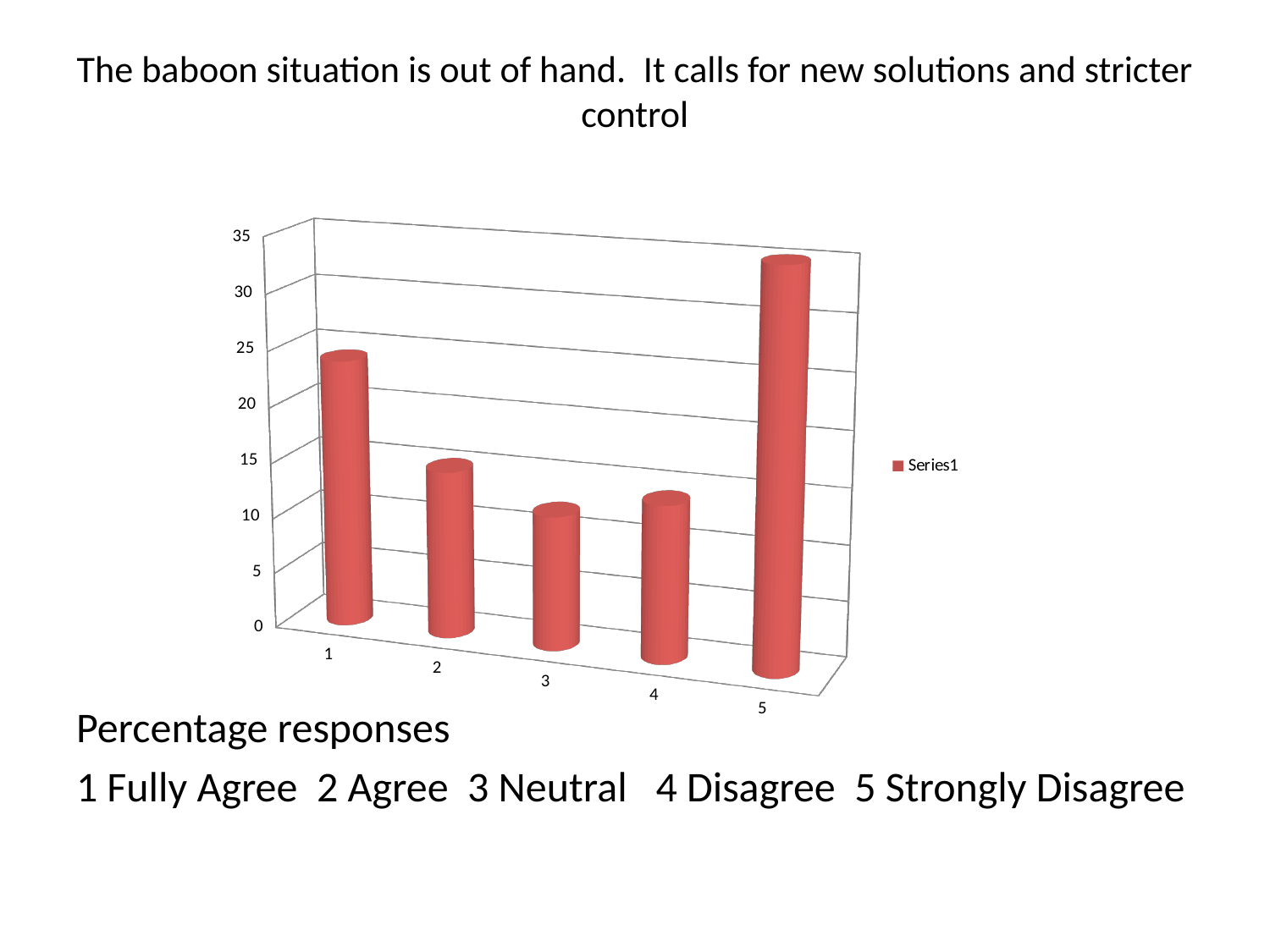
Is the value for category 5 greater or less than 25? greater Which category has the highest bar in the chart? 5 Is the value for category 1 greater or less than 20? greater Which is larger, the value for category 5 or the value for category 1? category 5 How many categories are plotted on the x axis of the chart? 5 Which is larger, the value for category 1 or the value for category 2? category 1 What is the name of the series shown in the chart legend? Series1 Is the value for category 3 greater or less than 15? less What kind of chart is shown on the slide? bar chart How many series does the chart legend list? 1